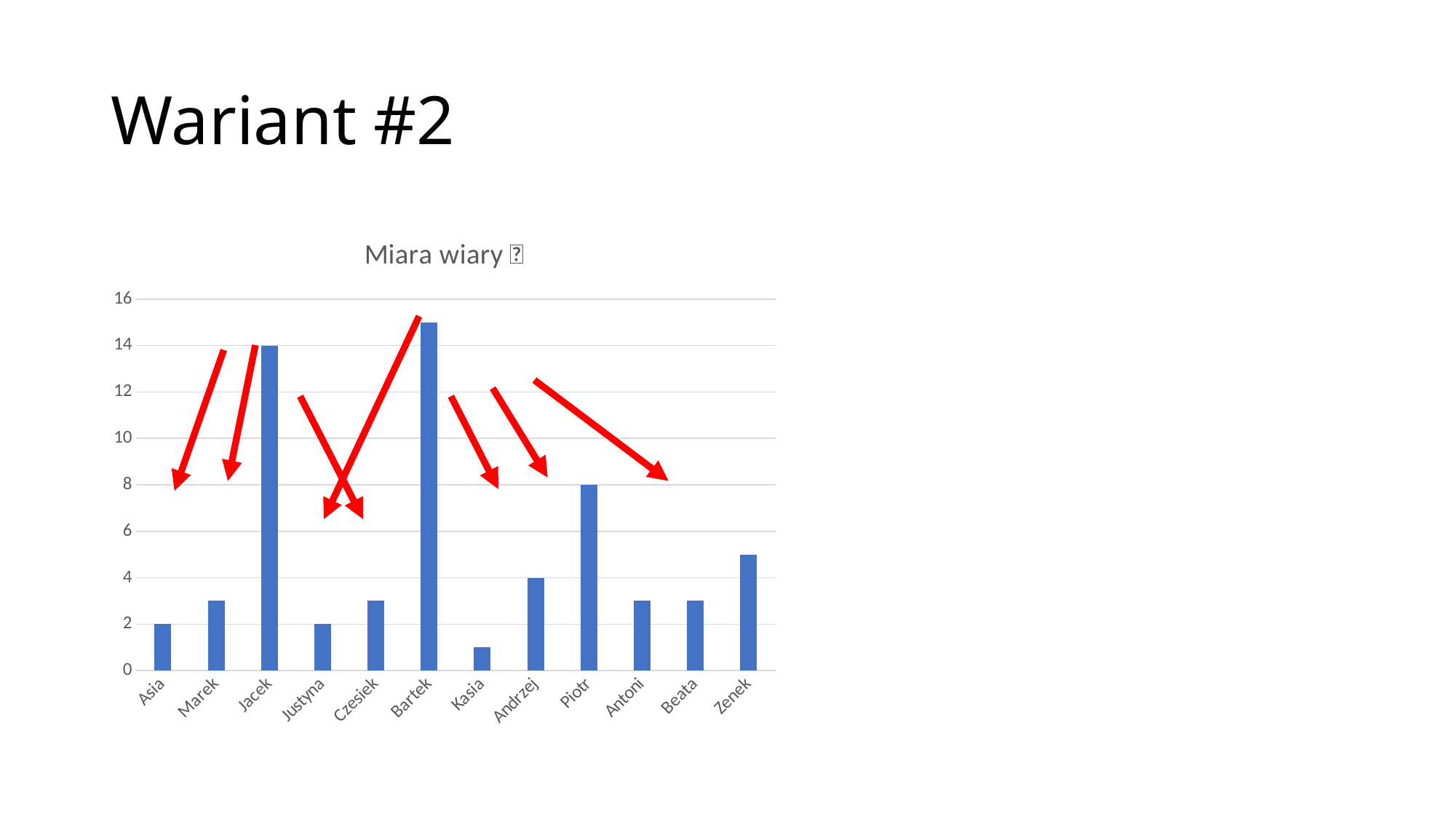
What is the value for Piotr? 8 Which is larger, the value for Piotr or the value for Zenek? Piotr Which person has the highest value in the chart? Bartek Which person has the lowest value in the chart? Kasia What kind of chart is shown on the slide? bar chart Is the value for Zenek greater or less than 6? less Is the value for Bartek greater or less than 14? greater What is the value for Jacek? 14 What is the value for Andrzej? 4 What colour are the bars in the chart? blue How many people (categories) are shown on the x axis of the chart? 12 What is the difference between the values for Jacek and Piotr? 6